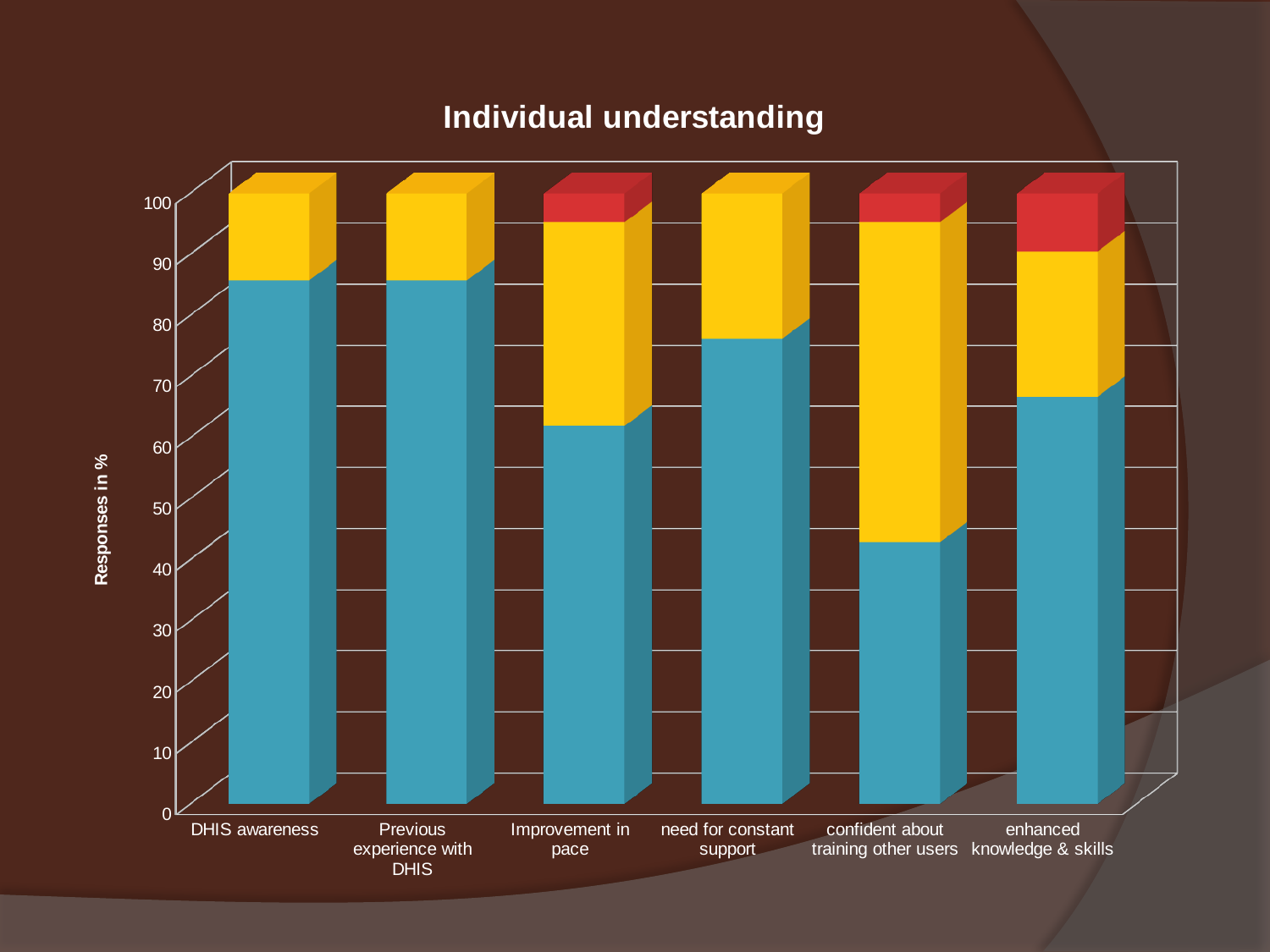
Is the blue segment for 'enhanced knowledge & skills' greater or less than 60? greater Which has the larger red segment, 'enhanced knowledge & skills' or 'Improvement in pace'? enhanced knowledge & skills Which category has the smallest blue segment? confident about training other users How many bars include a red segment? 3 What kind of chart is shown on the slide? Stacked bar chart Is the blue segment for 'DHIS awareness' greater or less than 80? greater What is the label on the vertical axis of the chart? Responses in % How many categories are shown along the x axis? 6 Is the blue segment for 'confident about training other users' greater or less than 50? less Which has the larger blue segment, 'need for constant support' or 'confident about training other users'? need for constant support What is the title of the chart? Individual understanding